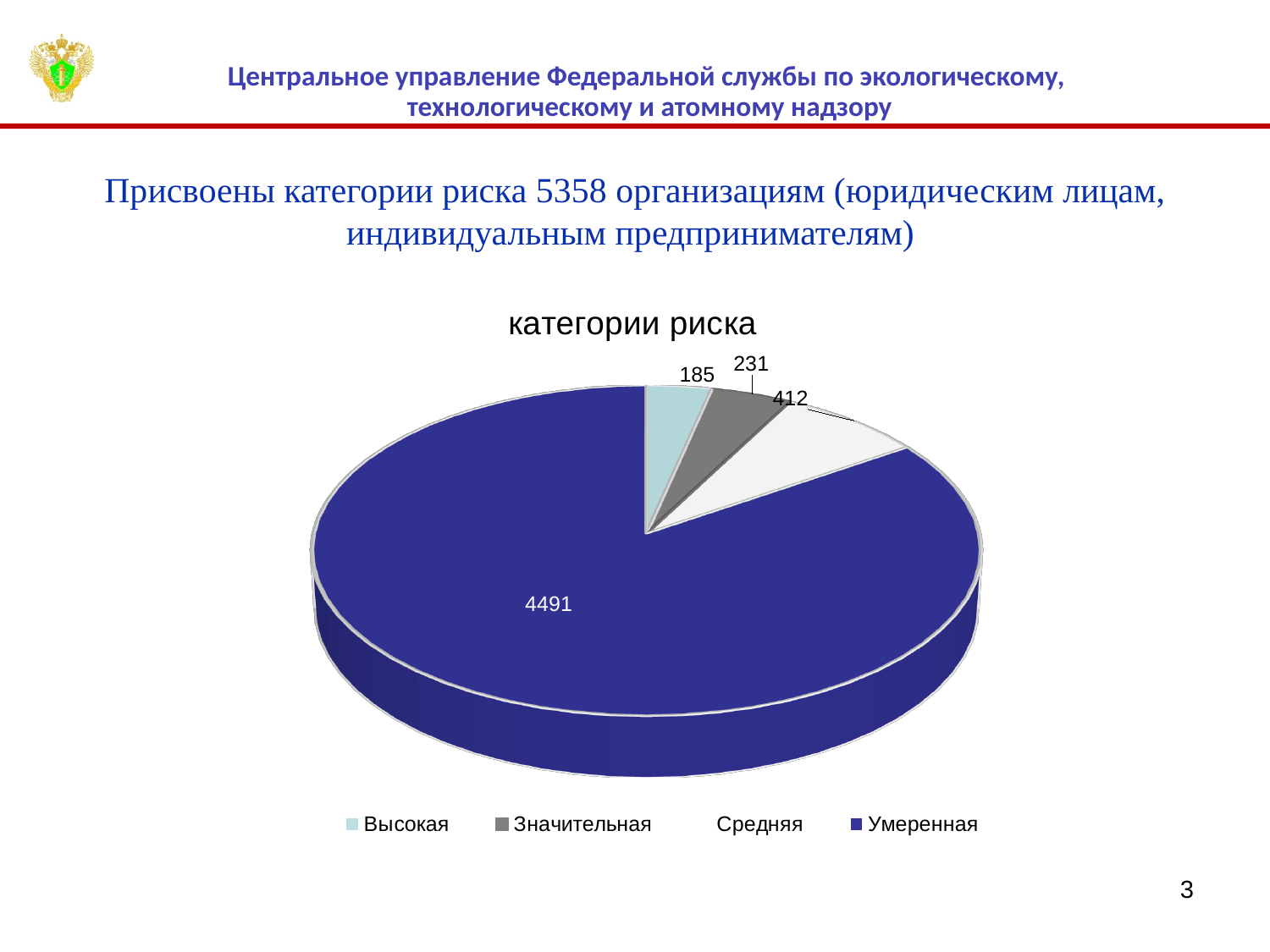
Which category has the smallest slice of the pie? Высокая What is the value for the Умеренная category? 4491 How many categories does the legend of the chart list? 4 What is the difference between the values for Средняя and Значительная? 181 What is the value for the Высокая category? 185 What is the total of all four slices in the pie chart? 5358 Which is larger, the value for Значительная or the value for Высокая? Значительная What type of chart is shown on the slide? pie chart Which category has the largest slice of the pie? Умеренная What is the value for the Значительная category? 231 What is the title of the chart? категории риска What is the value for the Средняя category? 412